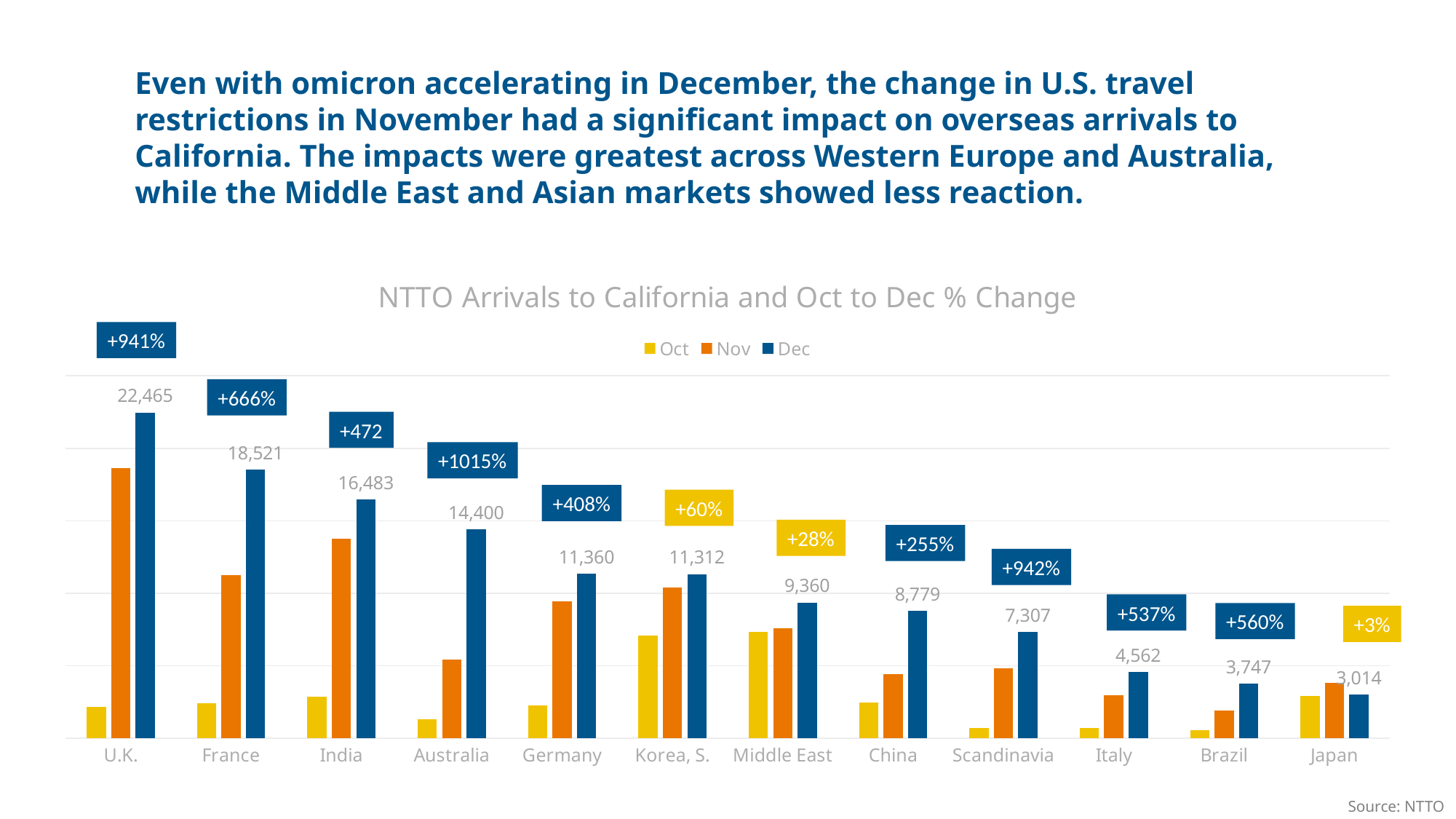
What Oct to Dec % change is shown for Japan? +3% Which category has the highest Dec value? U.K. What is the Dec value for Australia? 14,400 How many series does the legend list? 3 What kind of chart is this? Bar chart What is the Dec value for Scandinavia? 7,307 What Oct to Dec % change is shown for Australia? +1015% What is the difference between the Dec values for the U.K. and France? 3,944 Which category has the lowest Dec value? Japan Which has the larger Dec value, Germany or China? Germany What is the Dec value for the U.K.? 22,465 How many categories are shown on the x axis? 12